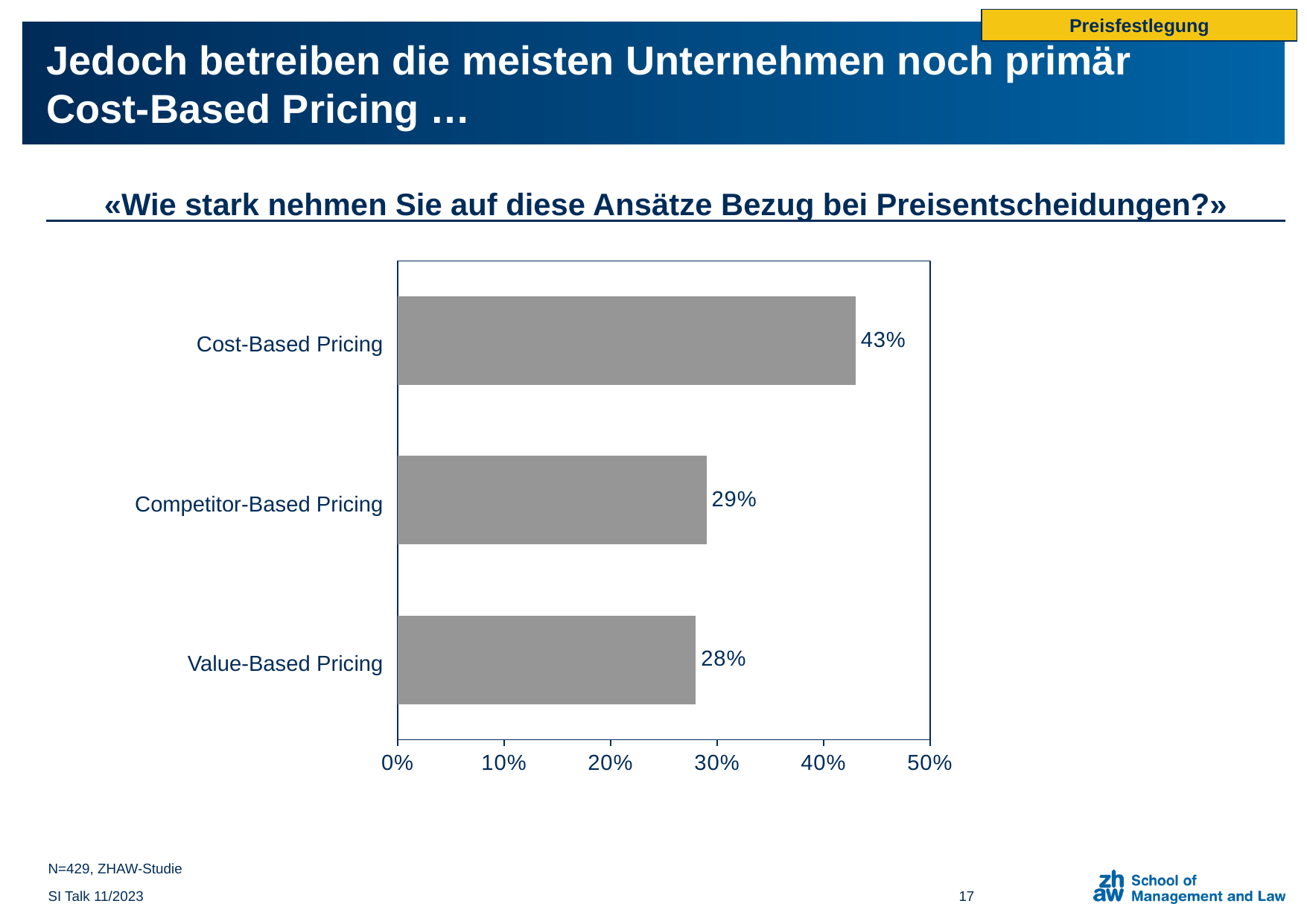
What is the difference between the values for Cost-Based Pricing and Value-Based Pricing? 15% Which pricing approach has the lowest value? Value-Based Pricing What is the maximum value shown on the horizontal axis? 50% What is the value for Value-Based Pricing? 28% Is the value for Cost-Based Pricing greater or less than 40%? greater What is the value for Competitor-Based Pricing? 29% Which pricing approach has the highest value? Cost-Based Pricing What is the value for Cost-Based Pricing? 43% What kind of chart is shown on the slide? bar chart How many pricing approaches are shown in the chart? 3 Which is larger, the value for Cost-Based Pricing or the value for Value-Based Pricing? Cost-Based Pricing What is the difference between the values for Cost-Based Pricing and Competitor-Based Pricing? 14%